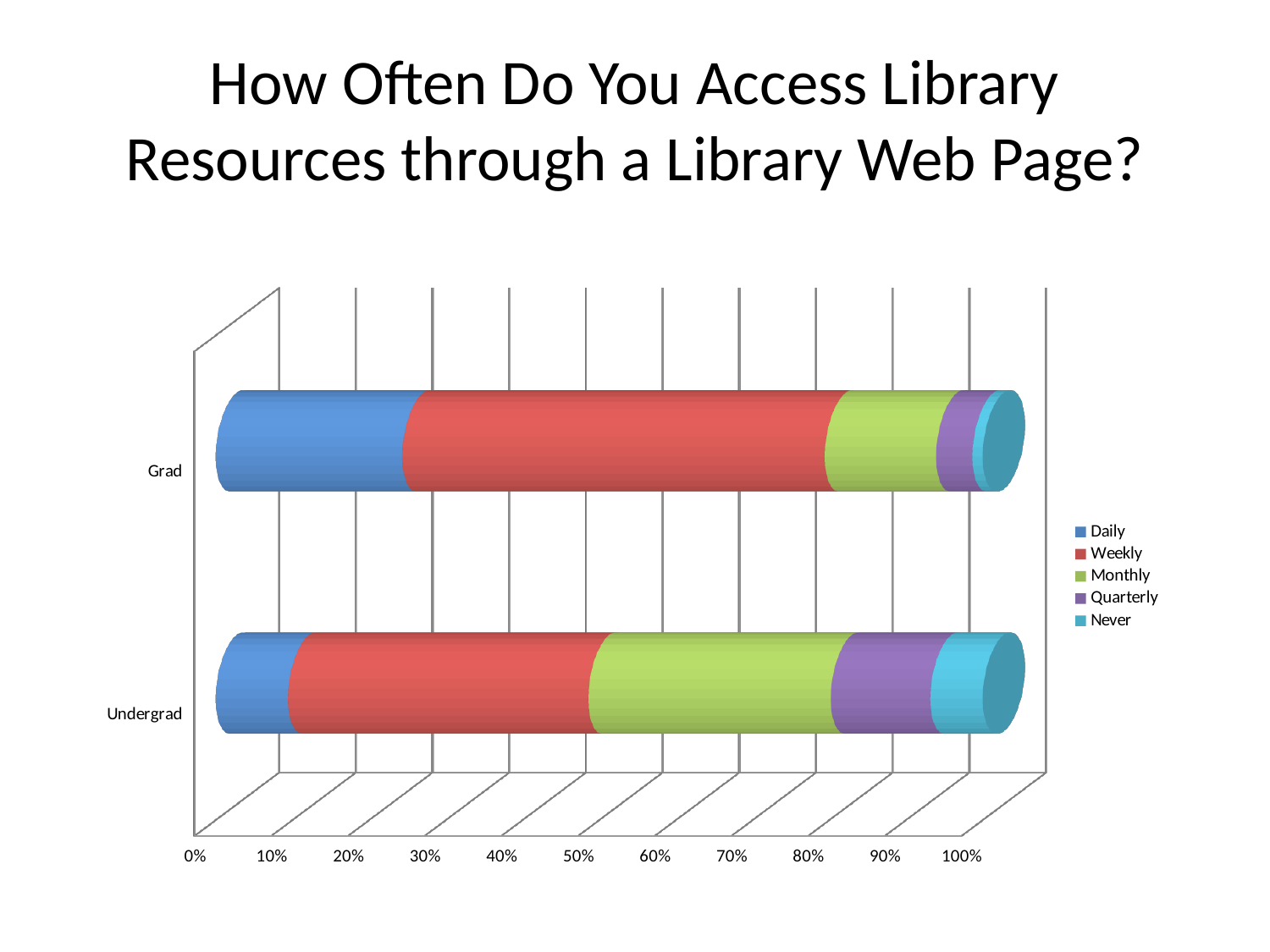
Which series is shown in red in the legend? Weekly Which response makes up the largest share of the Grad bar? Weekly Which group has the larger Never share, Grad or Undergrad? Undergrad Which response makes up the smallest share of the Undergrad bar? Never How many categories (groups of respondents) are shown on the y axis? 2 How many series does the legend list? 5 Which group has the larger Monthly share, Grad or Undergrad? Undergrad Which group has the larger Weekly share, Grad or Undergrad? Grad Is the Weekly share for Grad greater or less than 40%? greater Is the Daily share for Undergrad greater or less than 20%? less What is the title of the chart? How Often Do You Access Library Resources through a Library Web Page? What kind of chart is shown on the slide? Stacked bar chart